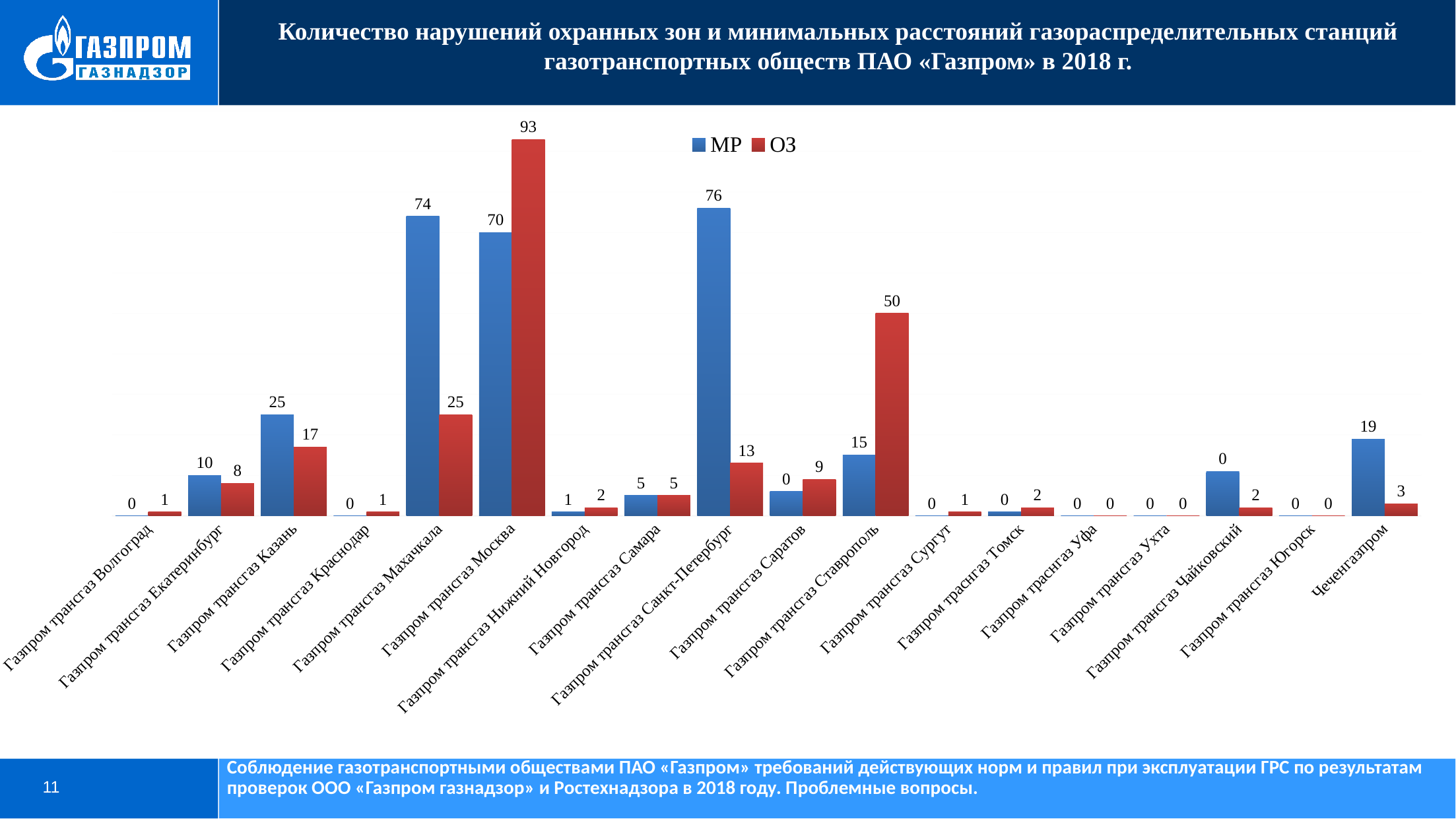
What are the two series names in the legend? МР and ОЗ How many companies are shown on the x axis? 18 For Газпром трансгаз Казань, which is larger, МР or ОЗ? МР What is the difference between the МР and ОЗ values for Газпром трансгаз Санкт-Петербург? 63 Which company has the highest ОЗ value? Газпром трансгаз Москва What is the ОЗ value for Газпром трансгаз Ставрополь? 50 What kind of chart is shown on the slide? bar chart What is the difference between the ОЗ and МР values for Газпром трансгаз Москва? 23 What is the МР value for Газпром трансгаз Махачкала? 74 What is the МР value for Чеченгазпром? 19 How many series does the legend list? 2 Which company has the highest МР value? Газпром трансгаз Санкт-Петербург